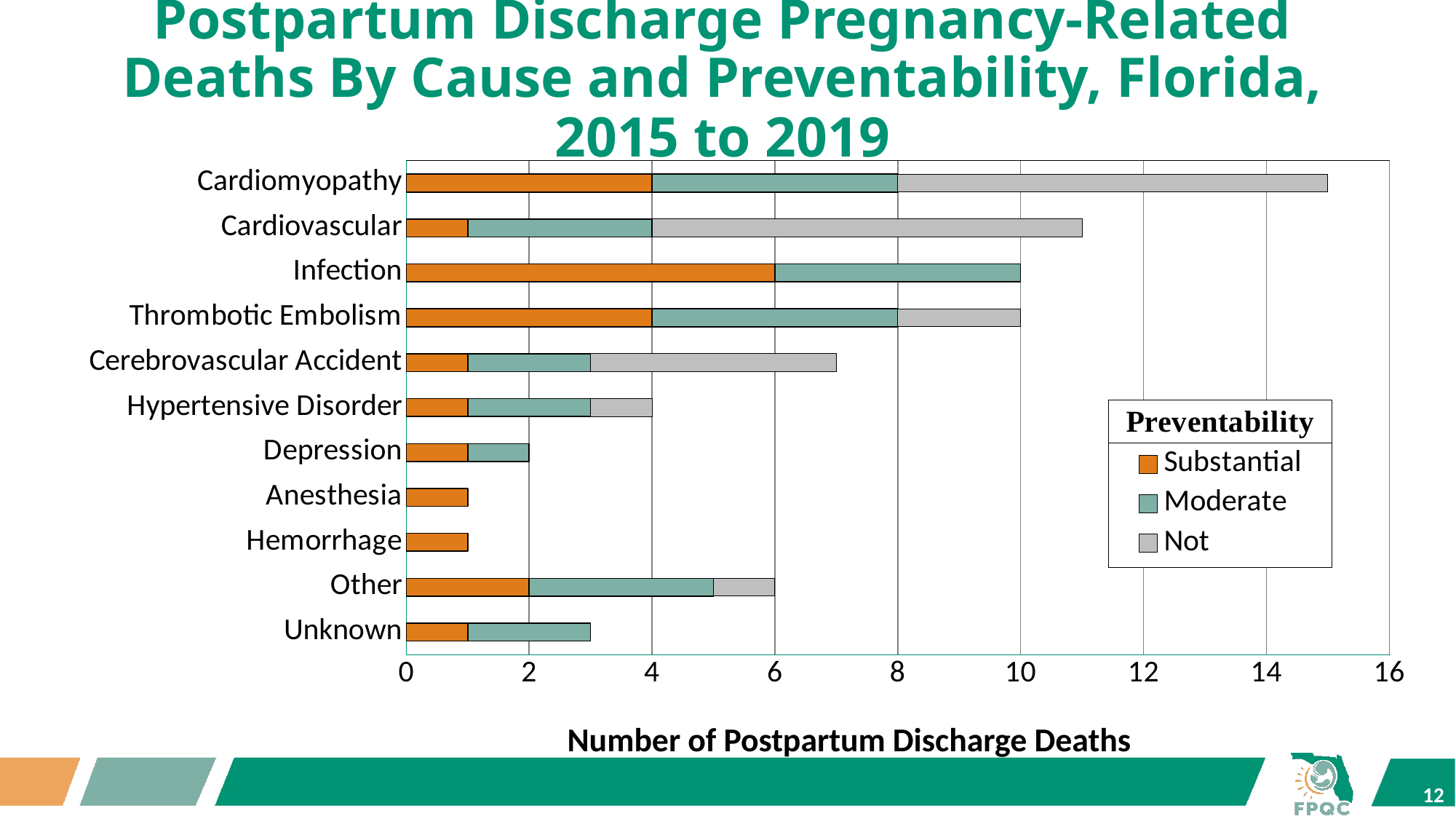
What is the difference between the total deaths for Infection and the total deaths for Hypertensive Disorder? 6 Which has more total postpartum discharge deaths, Cardiovascular or Thrombotic Embolism? Cardiovascular Which cause has the highest total number of postpartum discharge deaths? Cardiomyopathy Is the total number of deaths for Cardiomyopathy greater or less than 14? greater What is the total number of postpartum discharge deaths for Hypertensive Disorder? 4 What is the title of the legend? Preventability What is the total number of postpartum discharge deaths for Infection? 10 What is the total number of postpartum discharge deaths for Other? 6 What kind of chart is shown on the slide? Stacked bar chart Is the total number of deaths for Cerebrovascular Accident greater or less than 6? greater How many preventability categories does the legend list? 3 How many causes of death are listed on the vertical axis? 11